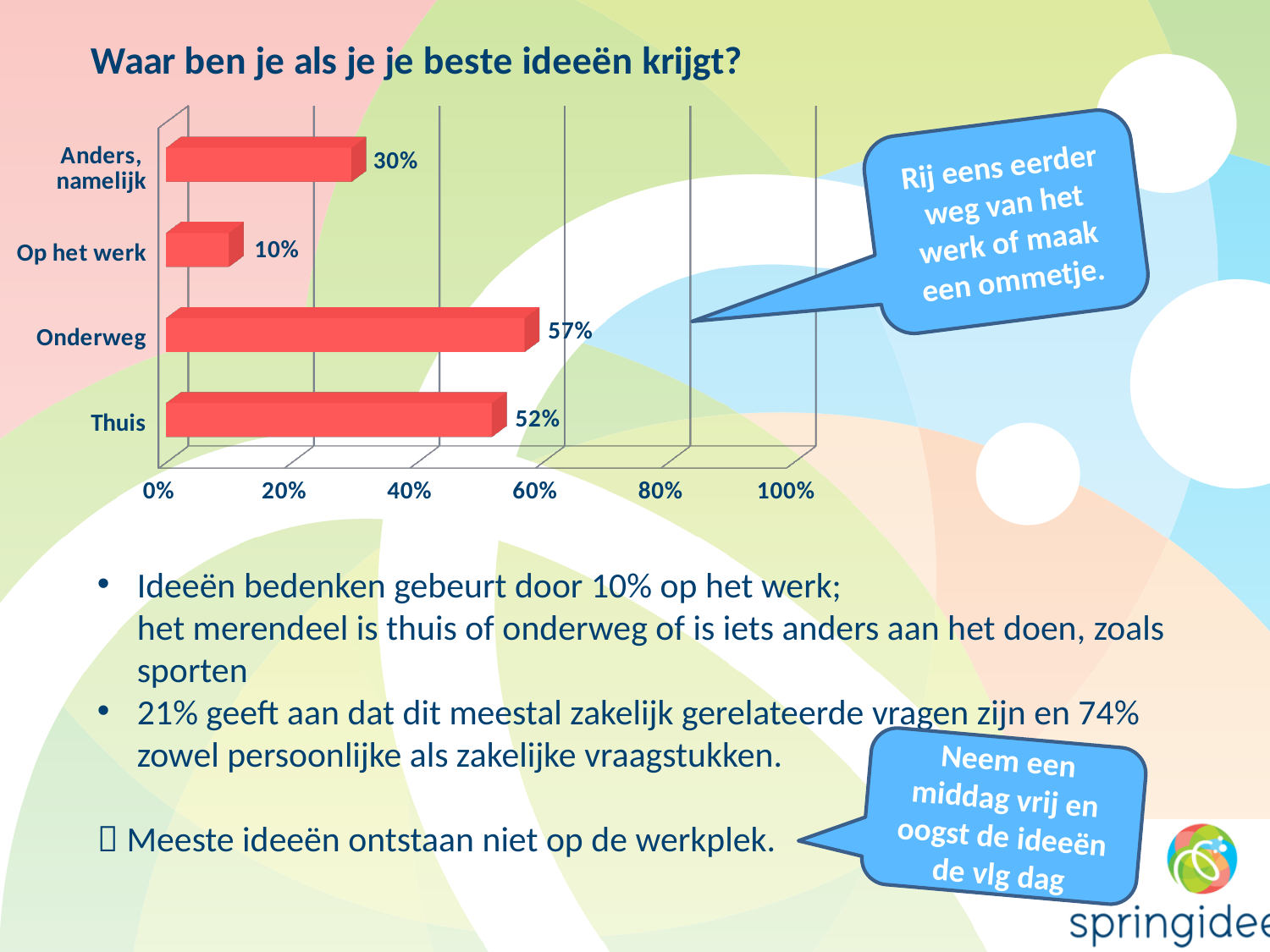
What is the value for Anders, namelijk? 30% What is the title of the chart? Waar ben je als je je beste ideeën krijgt? Which category has the highest value? Onderweg What is the value for Op het werk? 10% What kind of chart is shown on the slide? Bar chart What is the value for Onderweg? 57% What is the value for Thuis? 52% Which is larger, the value for Thuis or the value for Anders, namelijk? Thuis What is the difference between the values for Onderweg and Thuis? 5% How many categories are shown in the chart? 4 Which category has the lowest value? Op het werk What is the difference between the values for Anders, namelijk and Op het werk? 20%